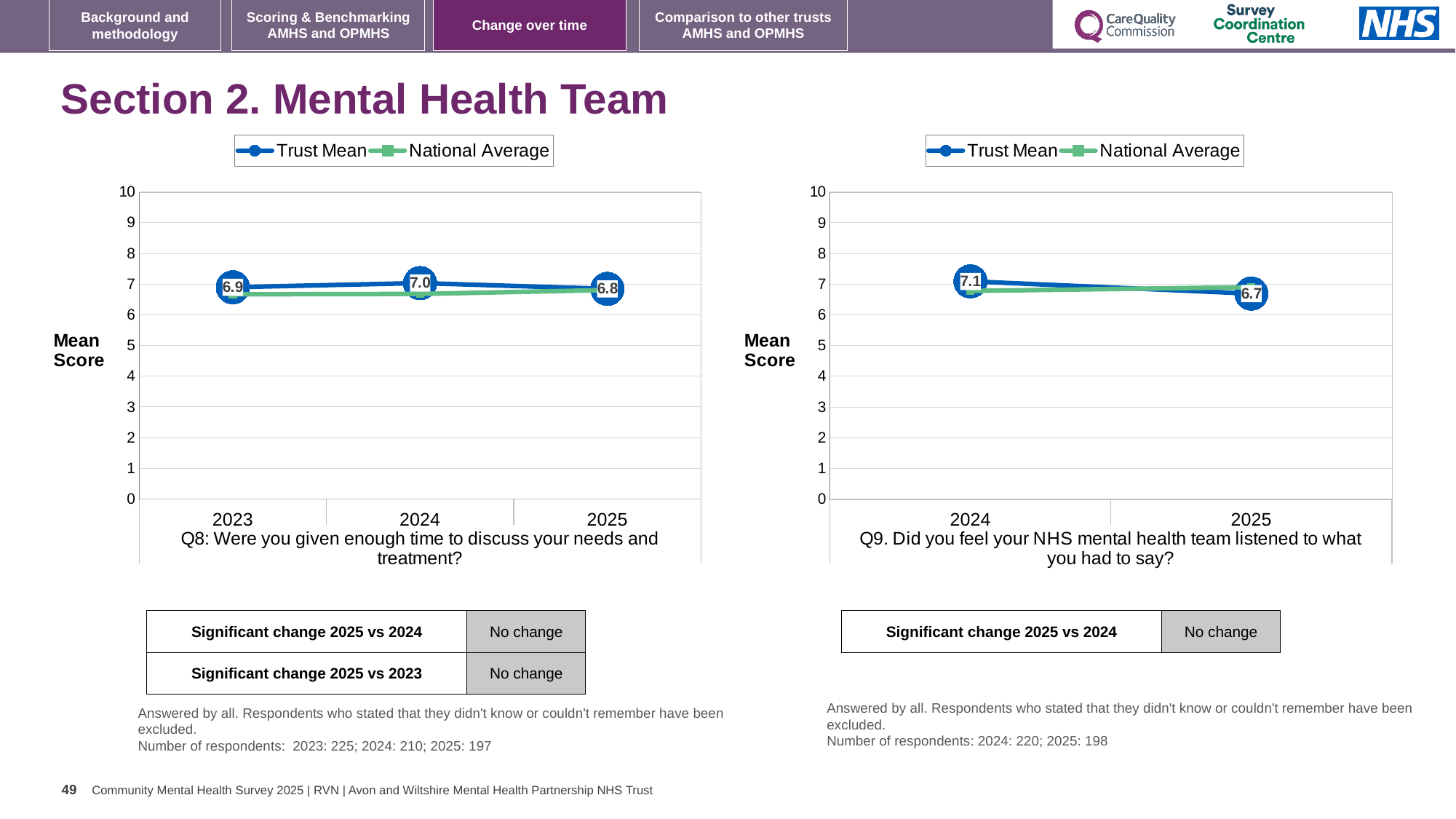
In the Q8 chart (left), which year has the lowest Trust Mean? 2025 In the Q8 chart (left), which year has the highest Trust Mean? 2024 In the Q9 chart (right), does the Trust Mean rise or fall from 2024 to 2025? fall How many series does the legend of the Q9 chart (right) list? 2 In the Q9 chart (right), what is the Trust Mean for 2025? 6.7 In the Q8 chart (left), is the Trust Mean higher in 2023 or in 2025? 2023 In the Q8 chart (left), what is the Trust Mean for 2024? 7.0 In the Q8 chart (left), what is the Trust Mean for 2023? 6.9 How many years are shown on the x axis of the Q8 chart (left)? 3 What kind of chart is the Q8 chart (left)? line chart In the Q9 chart (right), what is the Trust Mean for 2024? 7.1 In the Q9 chart (right), what is the difference between the Trust Mean for 2024 and 2025? 0.4